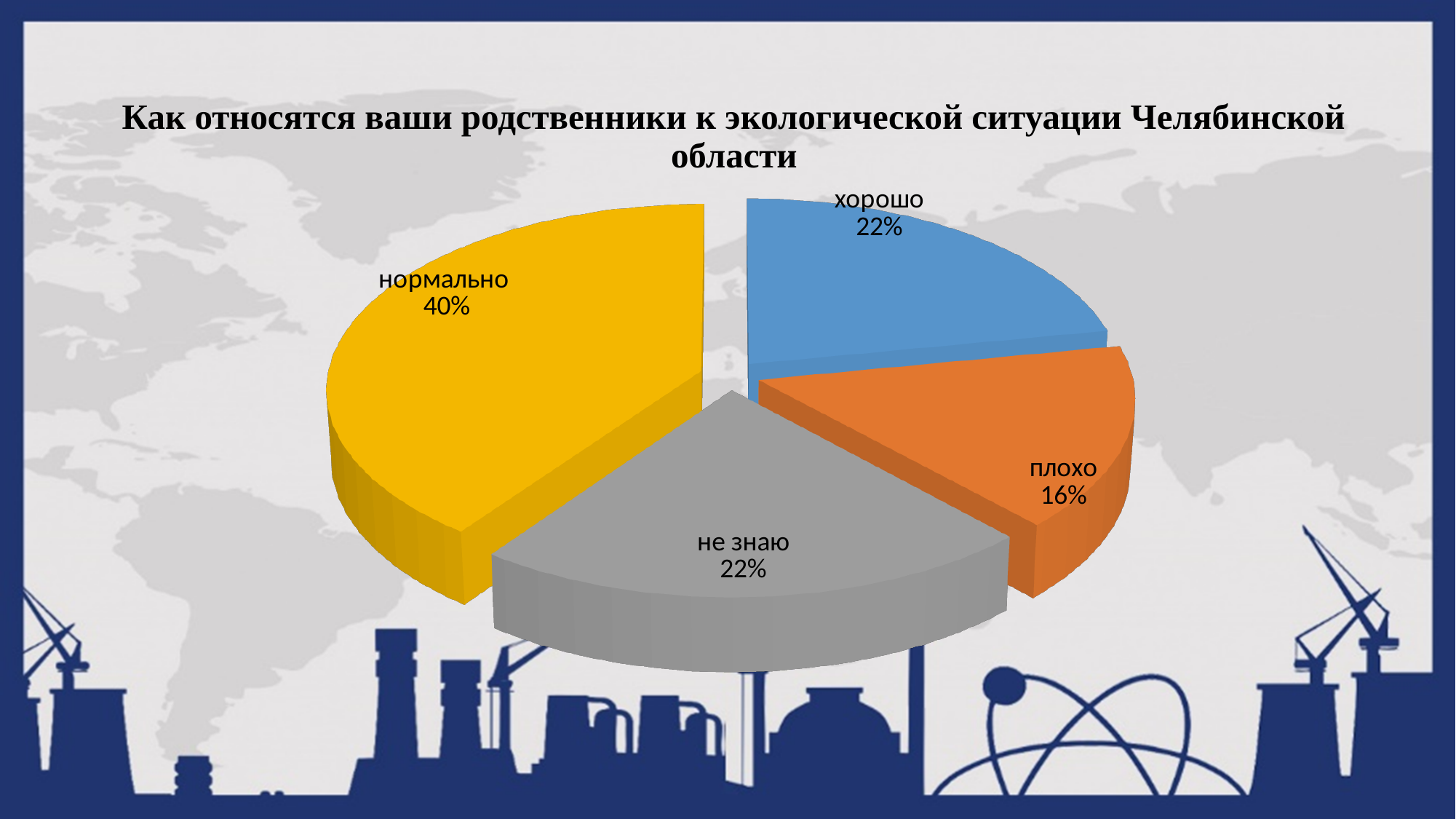
Which is larger, the share for 'нормально' or the share for 'хорошо'? нормально Which category has the smallest share of the pie? плохо What colour is the slice labelled 'не знаю'? grey What percentage of the pie is labelled 'нормально'? 40% What percentage of the pie is labelled 'плохо'? 16% What percentage of the pie is labelled 'хорошо'? 22% What percentage of the pie is labelled 'не знаю'? 22% What is the difference in percentage points between 'хорошо' and 'плохо'? 6 How many slices does the pie chart have? 4 What is the difference in percentage points between 'нормально' and 'плохо'? 24 Which category has the largest share of the pie? нормально What kind of chart is shown on the slide? pie chart